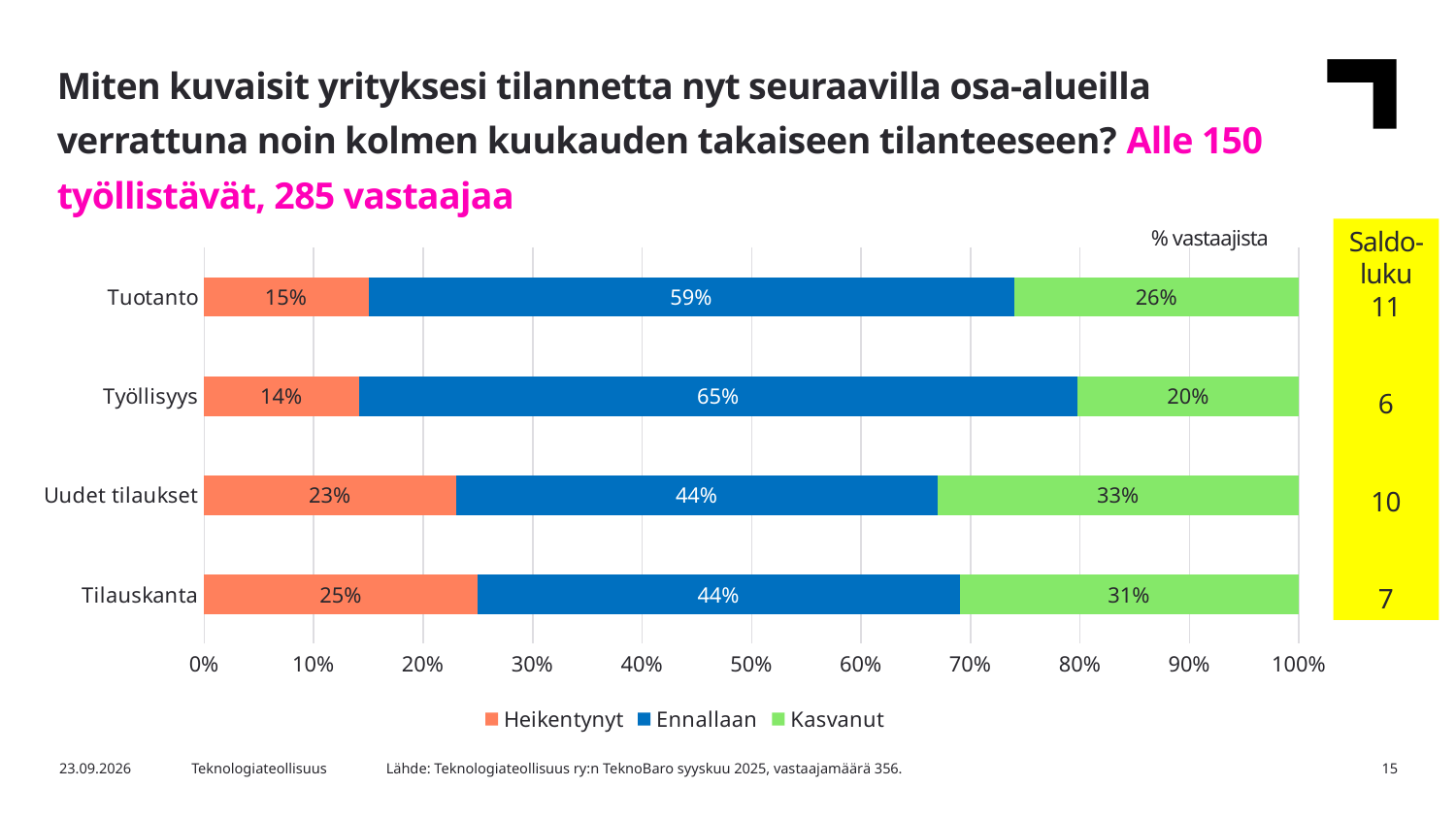
What is the Kasvanut value for Uudet tilaukset? 33% What is the Ennallaan value for Tuotanto? 59% What is the Heikentynyt value for Tilauskanta? 25% Which series is shown in green in the legend? Kasvanut How many series does the legend list? 3 How many categories are shown on the y axis of the chart? 4 Which category has the highest Ennallaan value? Työllisyys What kind of chart is shown on the slide? Stacked bar chart What is the Saldoluku value shown for Uudet tilaukset? 10 Which is larger, the Kasvanut value for Tuotanto or for Tilauskanta? Tilauskanta Which category has the lowest Kasvanut value? Työllisyys What is the difference between the Heikentynyt values for Tilauskanta and Tuotanto? 10%